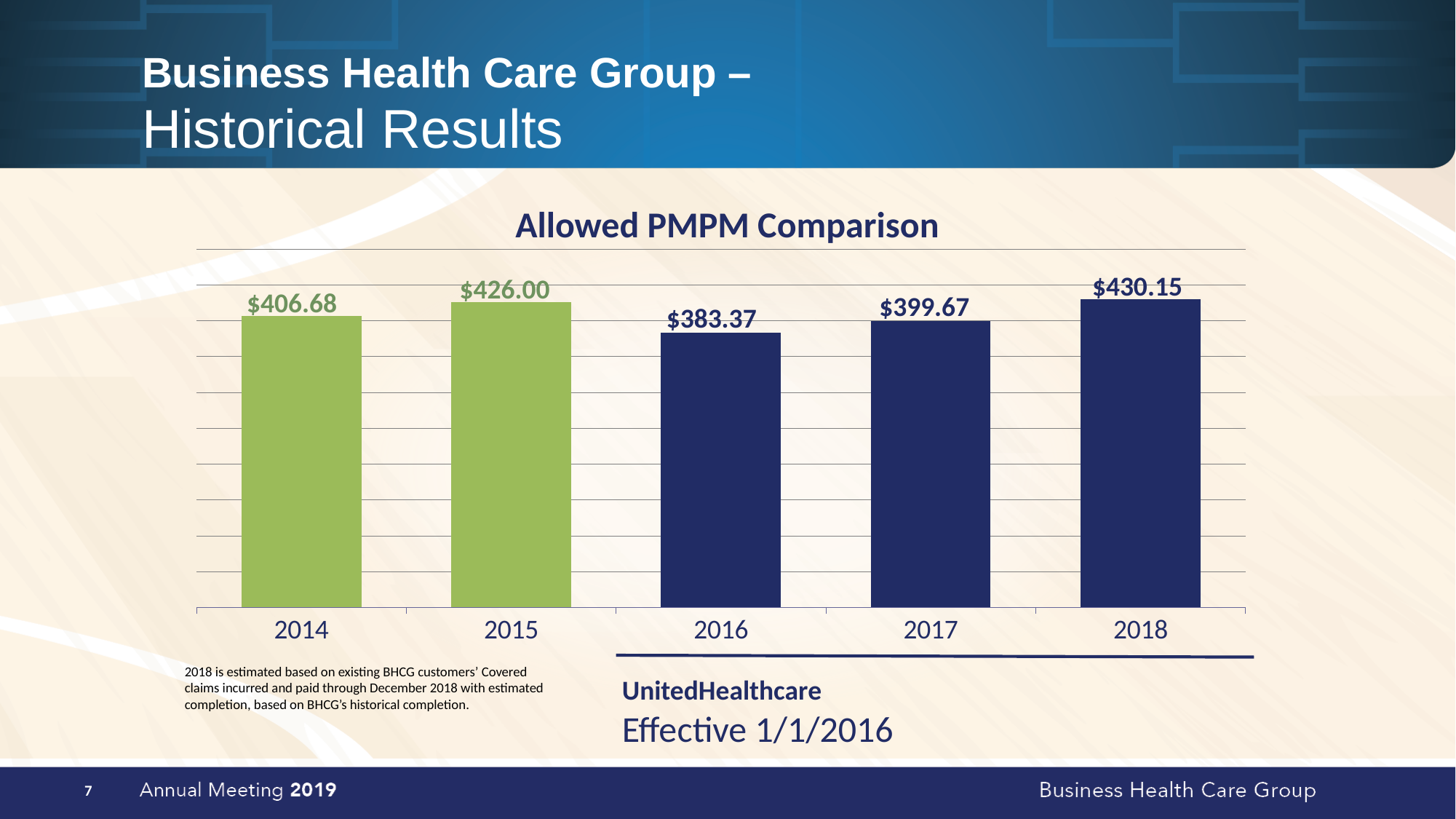
Do the Allowed PMPM values rise or fall from 2016 to 2018? Rise Which year has the highest Allowed PMPM value? 2018 What is the title of the chart? Allowed PMPM Comparison What is the difference between the Allowed PMPM values for 2015 and 2014? $19.32 What is the Allowed PMPM value for 2018? $430.15 What is the difference between the Allowed PMPM values for 2018 and 2016? $46.78 Which year has a larger Allowed PMPM value, 2015 or 2016? 2015 What kind of chart is shown on the slide? Bar chart Which year has the lowest Allowed PMPM value? 2016 What is the Allowed PMPM value for 2014? $406.68 What is the Allowed PMPM value for 2016? $383.37 How many years are shown in the chart? 5